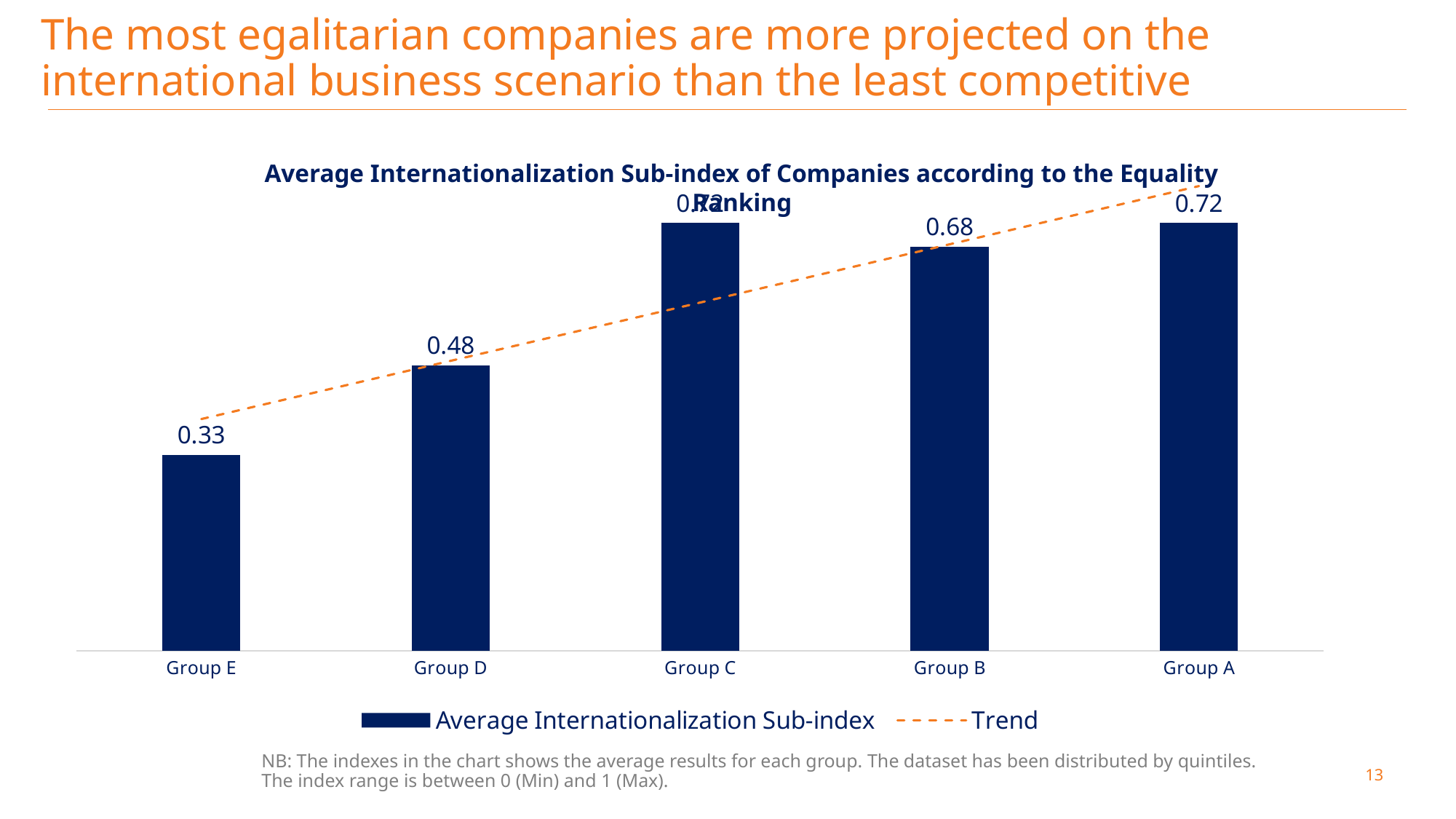
How many series does the chart legend list? 2 Which has a higher Average Internationalization Sub-index, Group D or Group E? Group D What kind of chart is used to show the Average Internationalization Sub-index? Bar chart What is the Average Internationalization Sub-index for Group E? 0.33 What is the Average Internationalization Sub-index for Group B? 0.68 What is the Average Internationalization Sub-index for Group D? 0.48 What is the difference between the sub-index values of Group A and Group B? 0.04 What is the Average Internationalization Sub-index for Group A? 0.72 Which group has the lowest Average Internationalization Sub-index? Group E What is the difference between the sub-index values of Group D and Group E? 0.15 Does the dashed Trend line rise or fall from Group E to Group A? Rise How many groups are shown on the x axis of the chart? 5